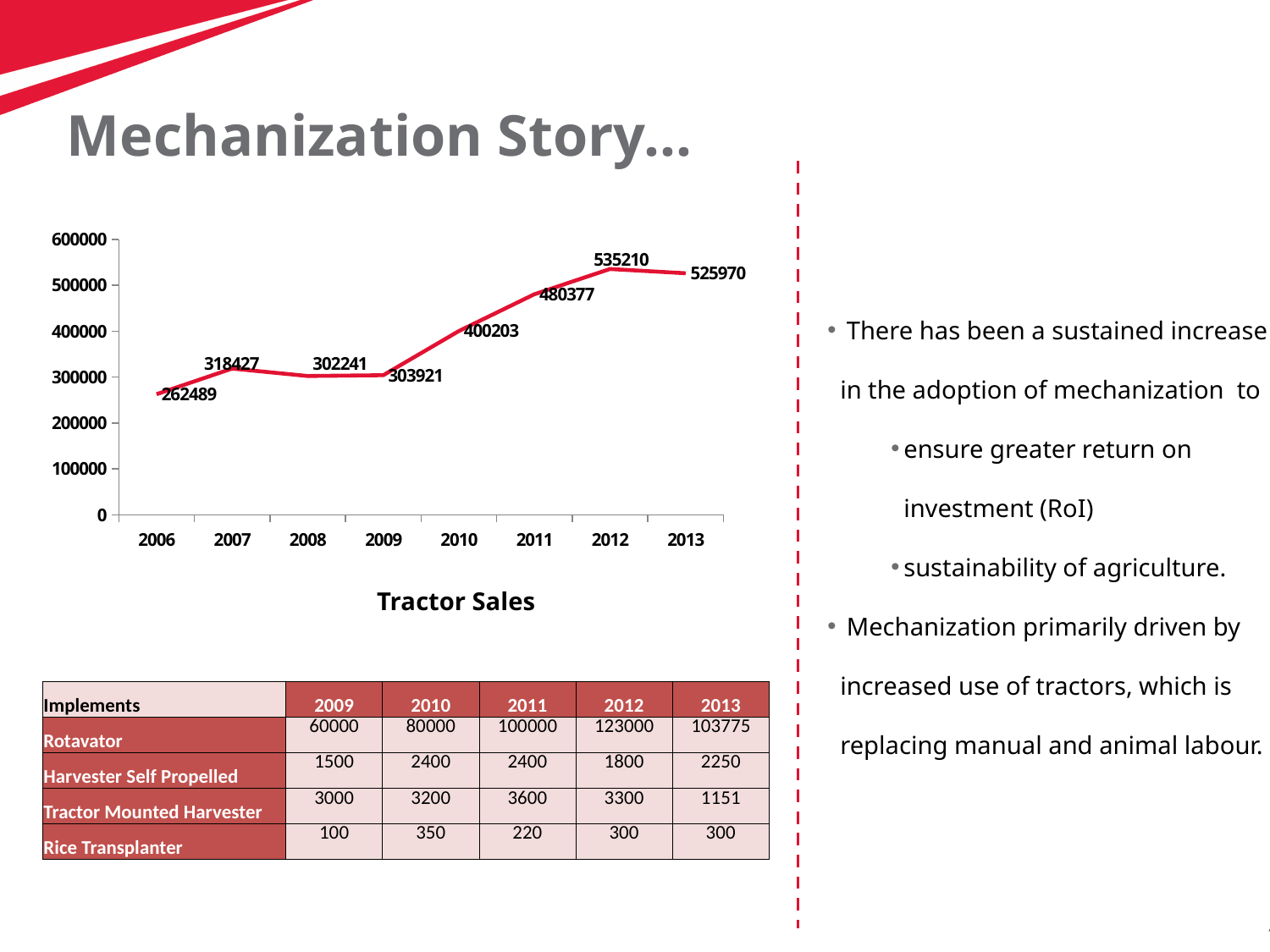
How many years are plotted on the Tractor Sales chart? 8 What is the title of the chart on the slide? Tractor Sales What is the difference in tractor sales between 2007 and 2006? 55938 Which year had higher tractor sales, 2008 or 2010? 2010 What is the difference in tractor sales between 2012 and 2011? 54833 Which year has the highest tractor sales? 2012 What is the tractor sales value for 2013? 525970 What is the tractor sales value for 2010? 400203 What kind of chart is used to show Tractor Sales? line chart Which year has the lowest tractor sales? 2006 What is the tractor sales value for 2006? 262489 Is the tractor sales value for 2011 greater or less than 400000? greater